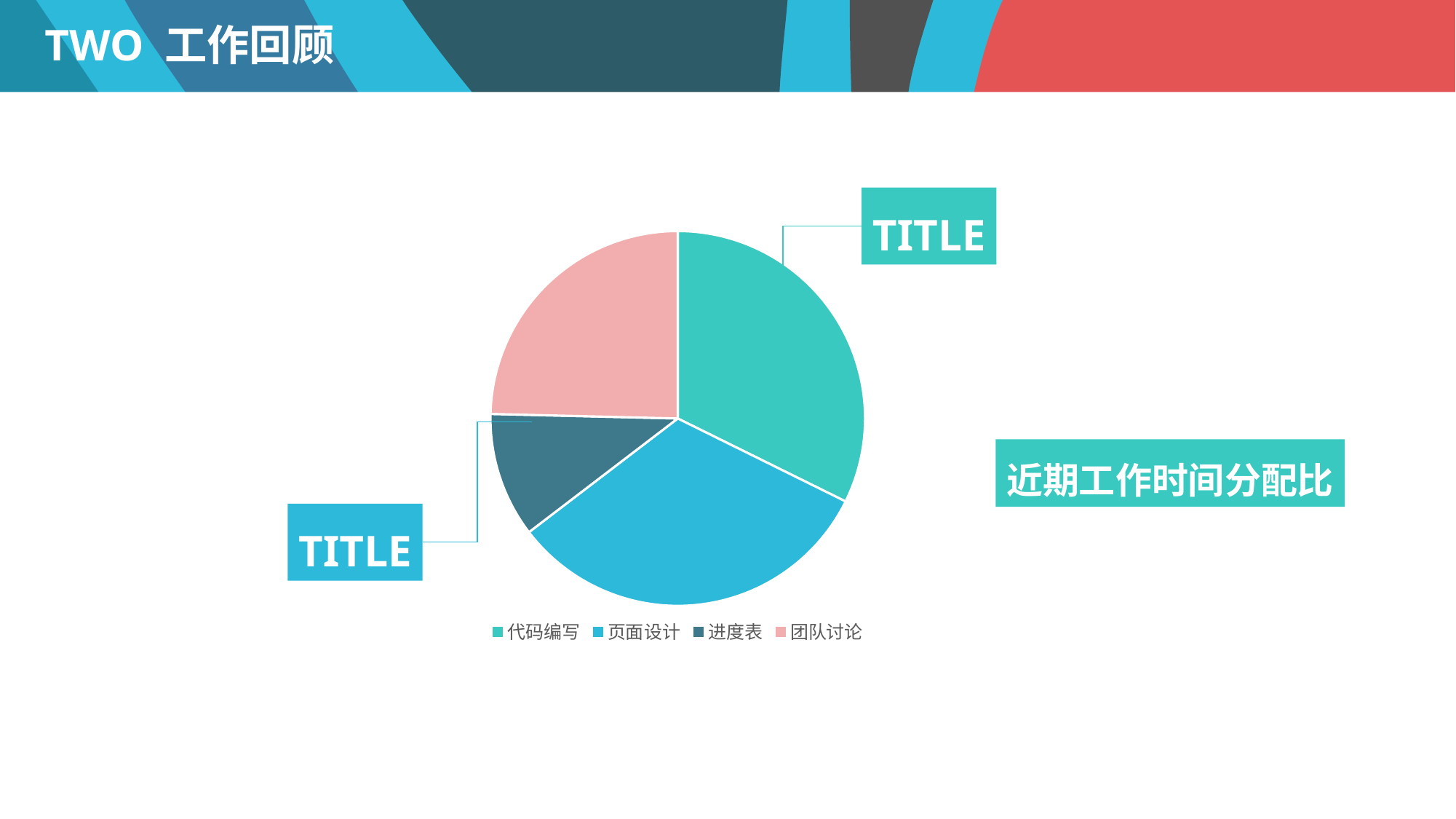
How many slices does the pie chart have? 4 What is the title shown next to the pie chart? 近期工作时间分配比 Which category has the smallest slice in the pie chart? 进度表 Which slice is larger, 代码编写 or 团队讨论? 代码编写 What kind of chart is shown on the slide? pie chart Which category is shown in pink in the pie chart? 团队讨论 Which slice is larger, 团队讨论 or 进度表? 团队讨论 Which slice is larger, 页面设计 or 团队讨论? 页面设计 How many entries does the legend of the pie chart list? 4